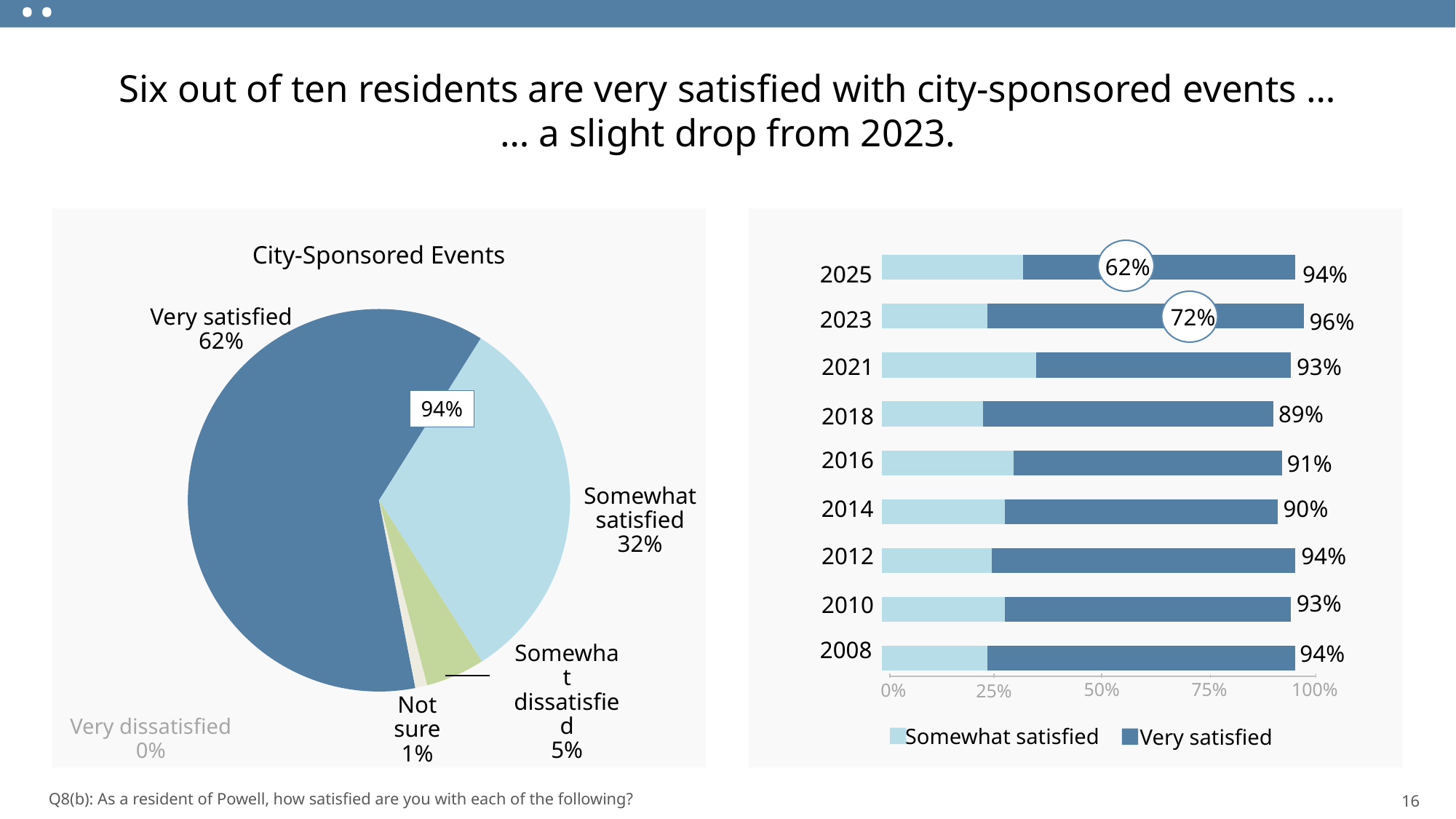
How many series does the legend of the bar chart on the right list? 2 In the City-Sponsored Events pie chart, what share of residents are somewhat dissatisfied? 5% In the bar chart on the right, which year has the highest total satisfied percentage? 2023 In the bar chart on the right, which year has the lowest total satisfied percentage? 2018 In the bar chart on the right, what is the Very satisfied percentage shown in the callout for 2023? 72% In the bar chart on the right, what is the total satisfied percentage shown for 2018? 89% In the City-Sponsored Events pie chart, what share of residents are very satisfied? 62% How many years are shown in the bar chart on the right? 9 In the bar chart on the right, what is the difference between the total satisfied percentage for 2023 and for 2025? 2 percentage points In the bar chart on the right, is the Somewhat satisfied value for 2021 greater or less than 25%? greater What kind of chart is the chart on the left of the slide? Pie chart In the City-Sponsored Events pie chart, which category has the largest slice? Very satisfied